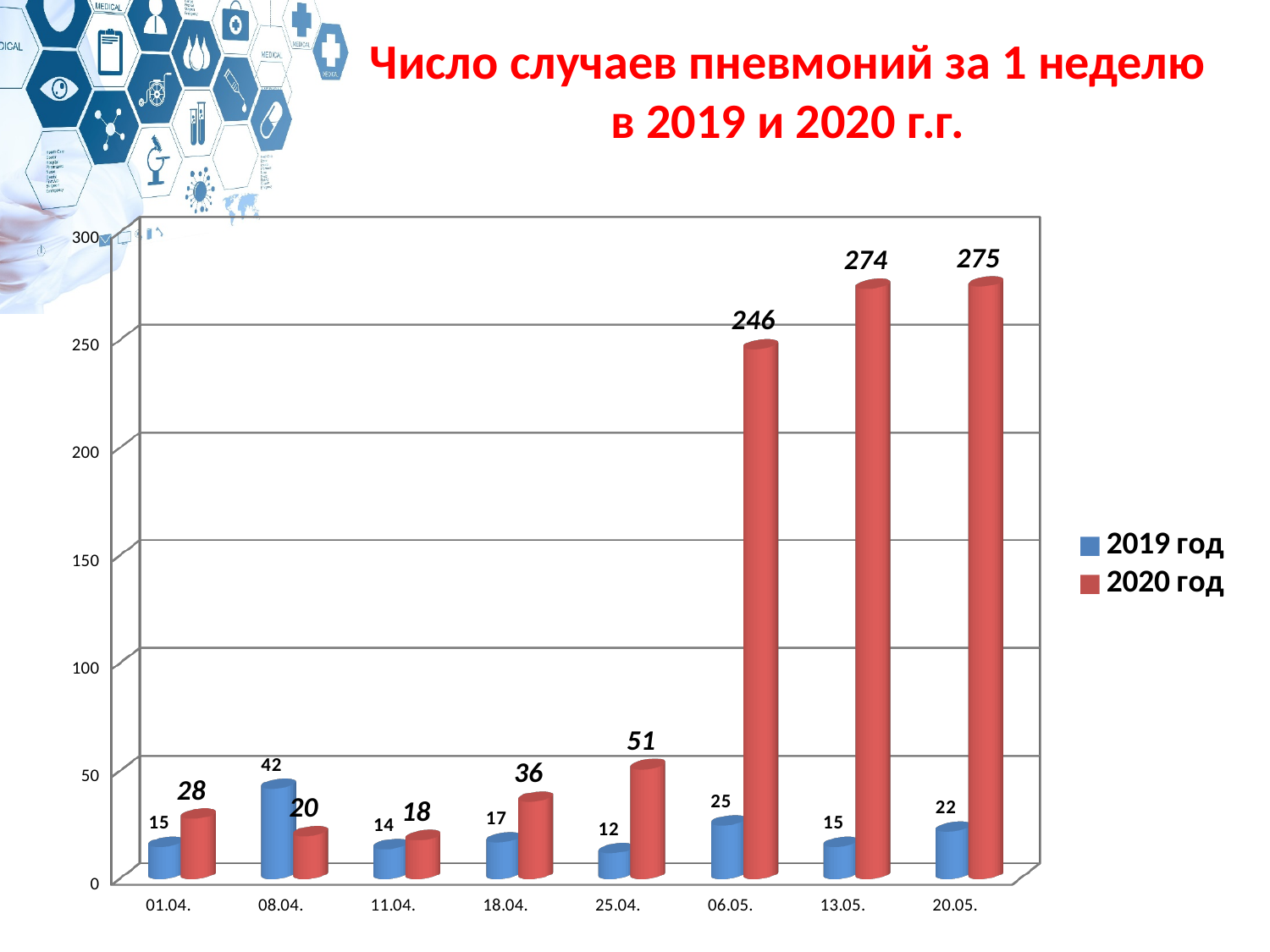
What is the value for 2020 год on 06.05.? 246 On which date is the 2020 год value highest? 20.05. What is the value for 2019 год on 08.04.? 42 What colour represents the 2020 год series? red What is the value for 2020 год on 25.04.? 51 Do the 2020 год values generally rise or fall from 18.04. to 20.05.? rise Which is larger on 08.04., the 2019 год value or the 2020 год value? 2019 год What is the difference between the 2020 год and 2019 год values on 13.05.? 259 How many series does the legend list? 2 What type of chart is shown on the slide? bar chart How many date categories are shown on the x axis? 8 On which date is the 2019 год value lowest? 25.04.